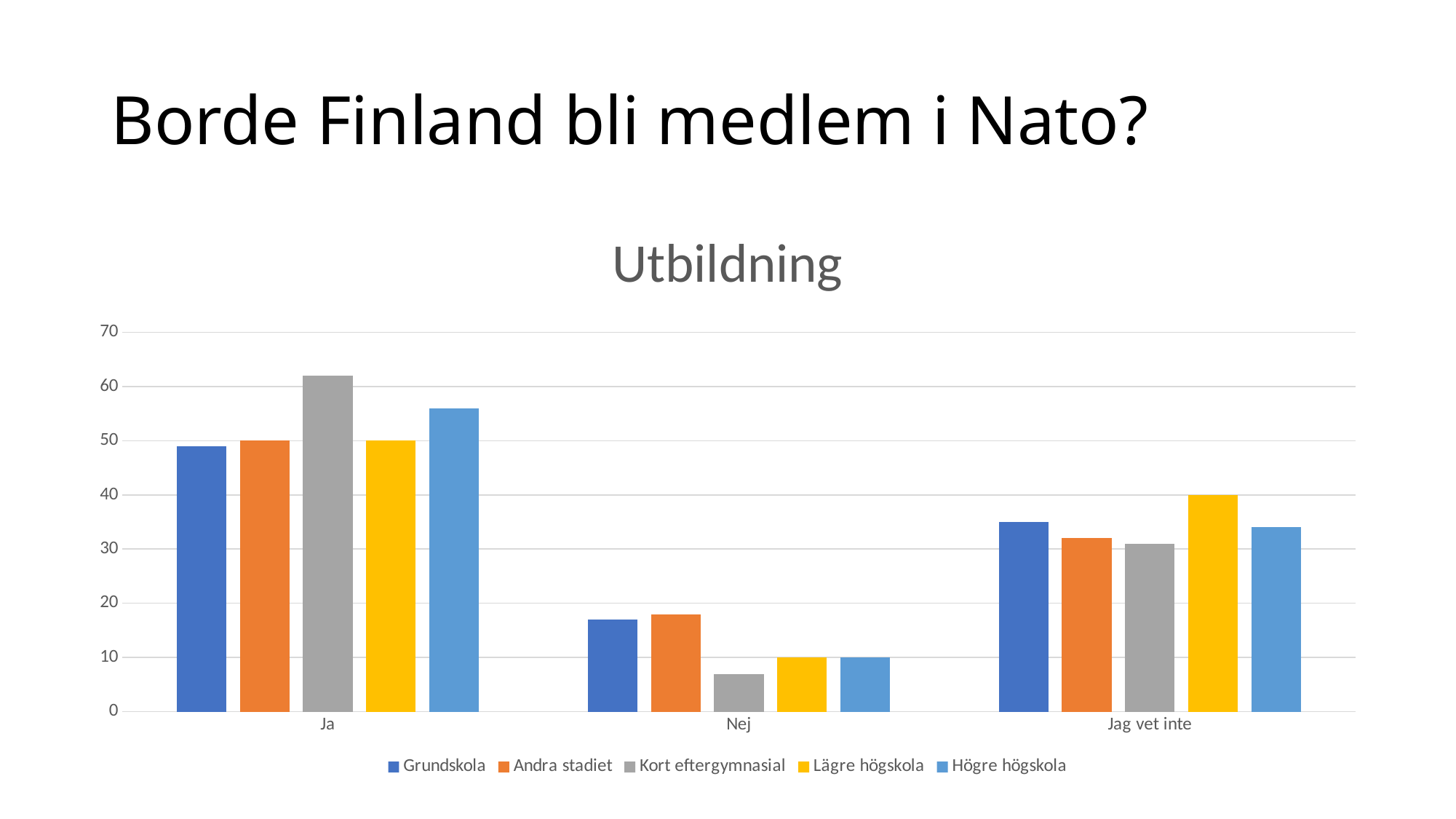
Which series has the highest value in the Ja category? Kort eftergymnasial How many categories are shown on the x axis? 3 What is the title of the chart? Utbildning In the Ja category, which is larger: the value for Högre högskola or the value for Grundskola? Högre högskola Is the value for Kort eftergymnasial in the Ja category greater or less than 60? greater Which category has the lowest values overall across all series? Nej What kind of chart is shown on the slide? bar chart How many series does the legend list? 5 Is the value for Grundskola in the Jag vet inte category greater or less than 30? greater Which series has the highest value in the Jag vet inte category? Lägre högskola Is the value for Kort eftergymnasial in the Nej category greater or less than 10? less Which series has the lowest value in the Nej category? Kort eftergymnasial